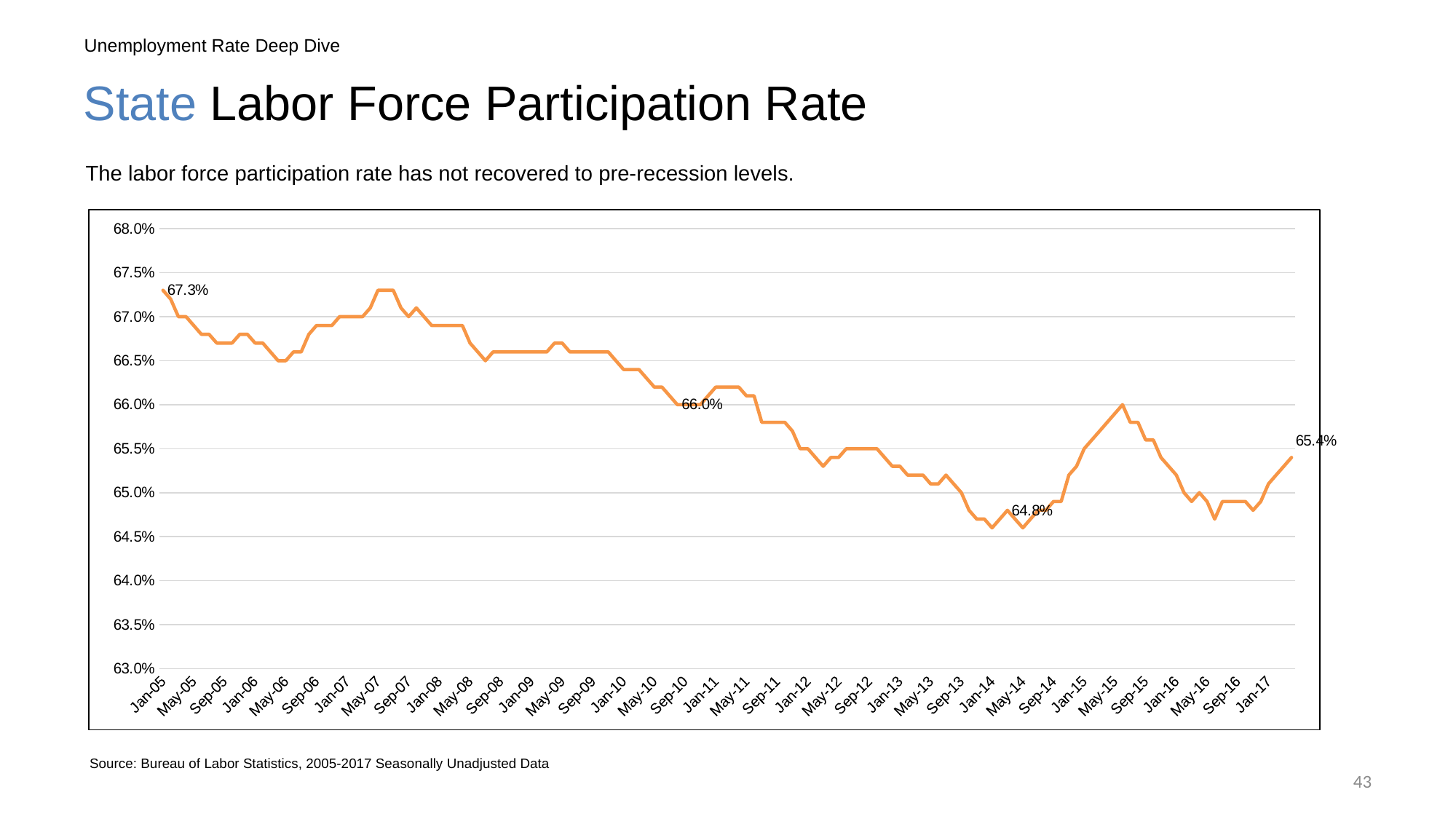
Which is larger: the labeled value near Sep-10 or the labeled value near May-14? Sep-10 (66.0%) What is the value of the last data point on the line? 65.4% Overall, does the labor force participation rate rise or fall from Jan-05 to the end of the series? fall What is the labor force participation rate shown for Jan-05? 67.3% What source is cited for the chart data? Bureau of Labor Statistics, 2005-2017 Seasonally Unadjusted Data What kind of chart is shown on the slide? line chart Is the value for Jan-05 greater or less than 67.0%? greater What is the highest value shown on the y-axis? 68.0% What is the difference between the labeled value 67.3% and the labeled value 64.8%? 2.5 percentage points Is the value for May-15 greater or less than 65.5%? greater Is the value for Jan-14 greater or less than 65.0%? less What is the difference between the labeled value at Jan-05 (67.3%) and the labeled value at the end of the line (65.4%)? 1.9 percentage points